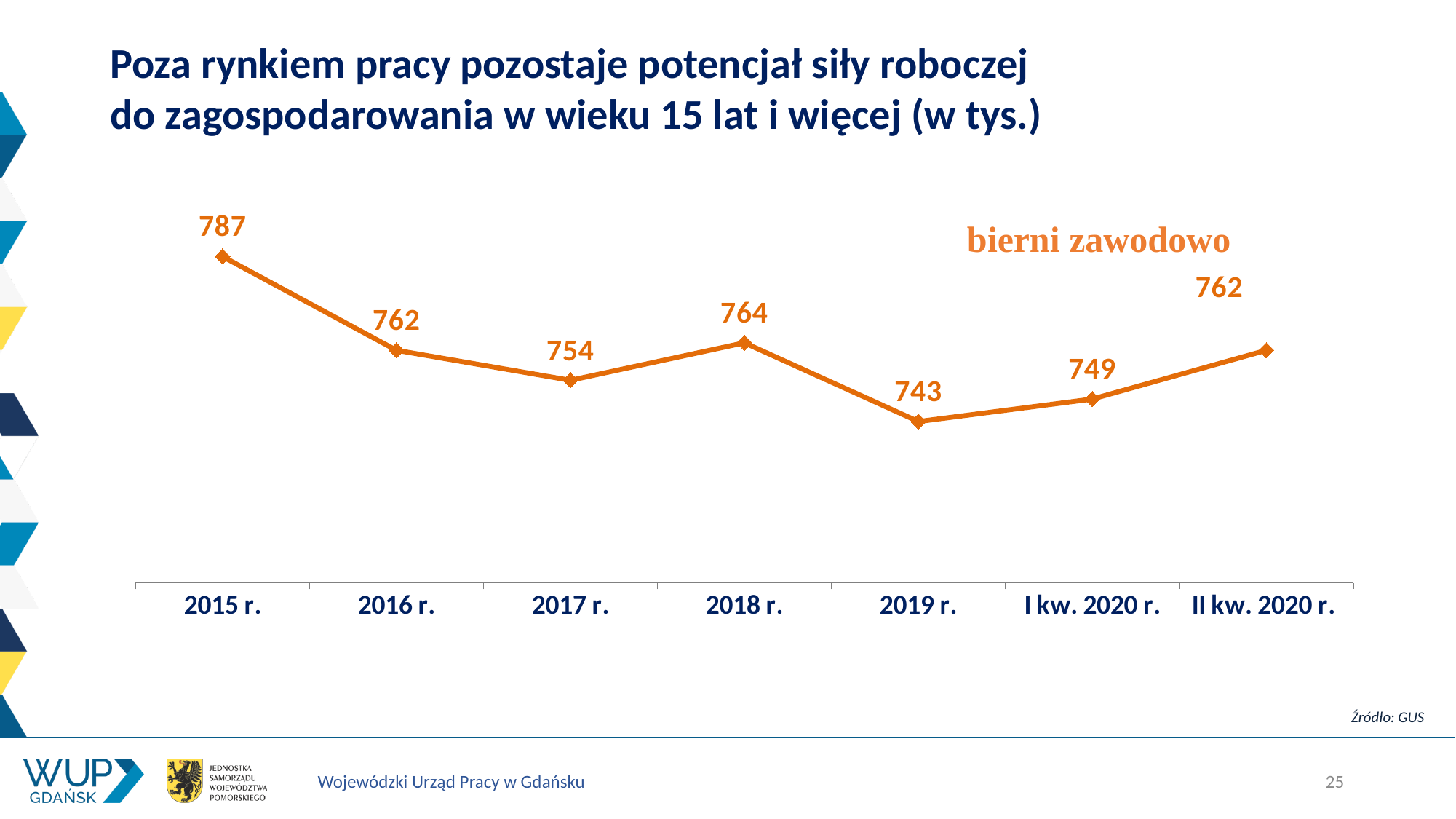
What is the difference between the values for 2015 r. and 2019 r.? 44 How many data points are plotted on the chart? 7 What is the name of the series shown on the chart? bierni zawodowo What is the value for 2019 r.? 743 What is the difference between the values for II kw. 2020 r. and I kw. 2020 r.? 13 Which category has the highest value? 2015 r. Which category has the lowest value? 2019 r. What is the value for 2015 r.? 787 Which is larger, the value for 2017 r. or the value for 2018 r.? 2018 r. What is the value for II kw. 2020 r.? 762 What is the value for 2018 r.? 764 What kind of chart is shown on the slide? line chart